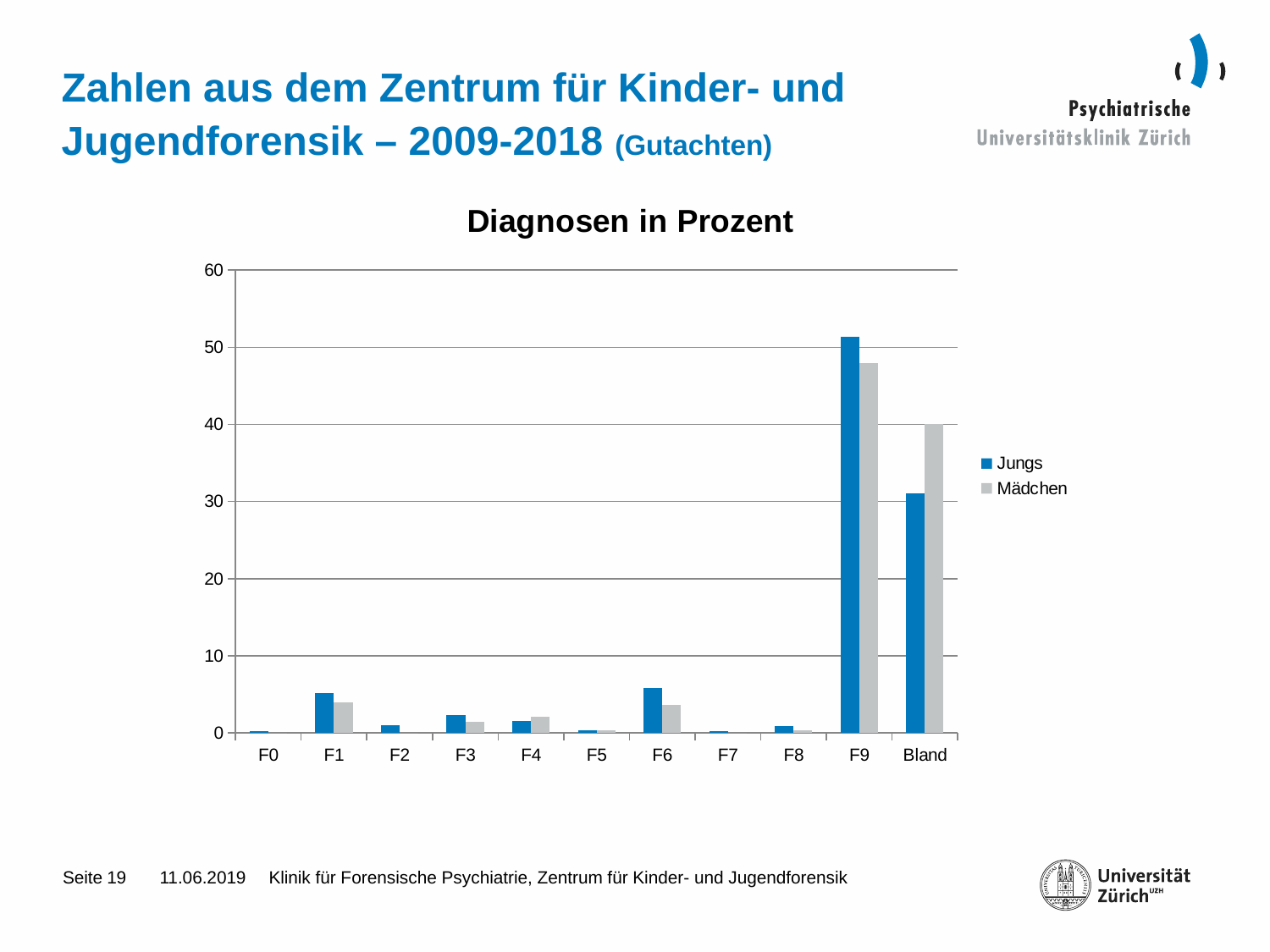
How many series does the legend of the chart list? 2 Is the value for Jungs at F9 greater or less than 50? greater What is the title of the chart? Diagnosen in Prozent How many categories are shown on the x axis of the chart? 11 Which category has the highest value for Jungs? F9 Is the value for Jungs at Bland greater or less than 40? less Is the value for Jungs at F6 greater or less than 10? less What kind of chart is shown on the slide? Bar chart Which category has the highest value for Mädchen? F9 At Bland, which series has the larger value, Jungs or Mädchen? Mädchen At F9, which series has the larger value, Jungs or Mädchen? Jungs